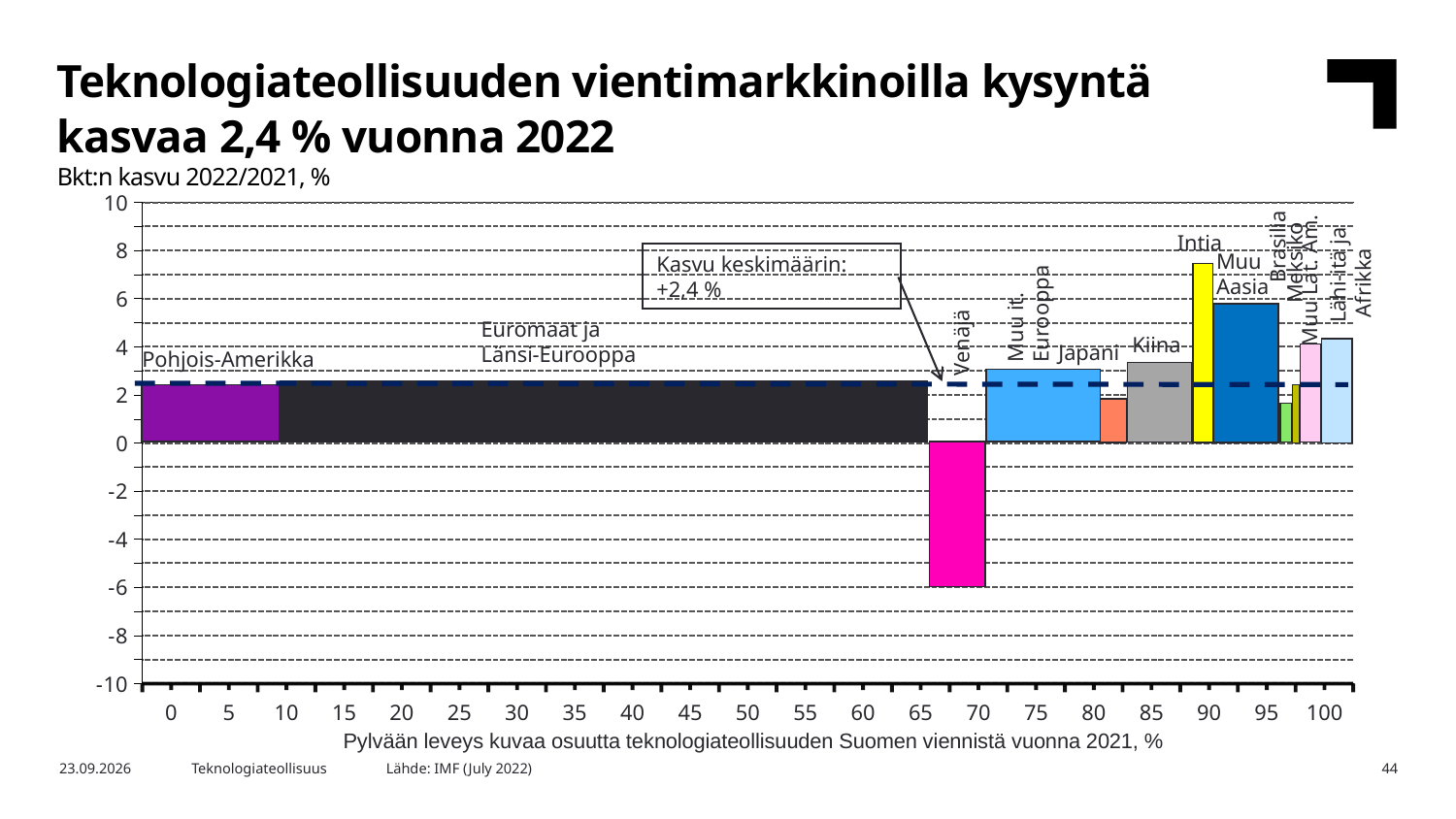
Is the value for Venäjä greater or less than -4? less Is the value for Intia greater or less than 6? greater What is the average growth (Kasvu keskimäärin) shown on the chart? +2,4 % Is the value for Japani greater or less than 2? less Which has the larger value, Intia or Muu Aasia? Intia Which has the larger value, Kiina or Japani? Kiina According to the note below the x axis, what does the width of each bar represent? Osuutta teknologiateollisuuden Suomen viennistä vuonna 2021, % What kind of chart is shown on the slide? bar chart Which region has the highest GDP growth in the chart? Intia Which region has the lowest GDP growth in the chart? Venäjä What is the source of the data given on the slide? IMF (July 2022)